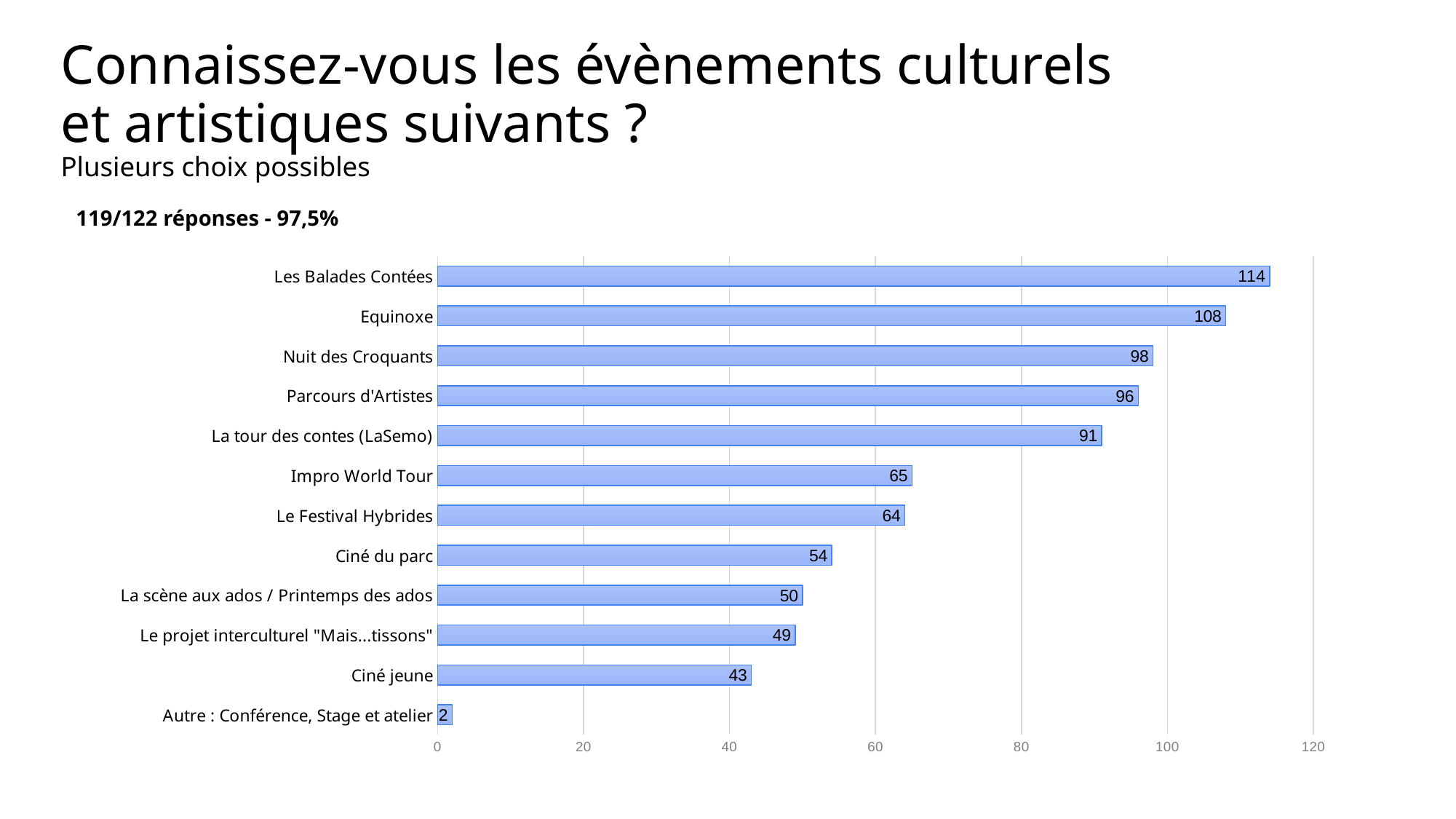
How many categories are shown in the chart? 12 What is the maximum value shown on the horizontal axis? 120 What is the value for Ciné du parc? 54 Which category has the lowest value? Autre : Conférence, Stage et atelier What is the difference between the values for Les Balades Contées and Ciné jeune? 71 What is the difference between the values for Equinoxe and Nuit des Croquants? 10 Is the value for Parcours d'Artistes greater or less than 80? greater Which category has the highest value? Les Balades Contées What kind of chart is shown on the slide? bar chart What is the value for Les Balades Contées? 114 What is the value for La tour des contes (LaSemo)? 91 Which is larger, the value for Impro World Tour or the value for Ciné jeune? Impro World Tour